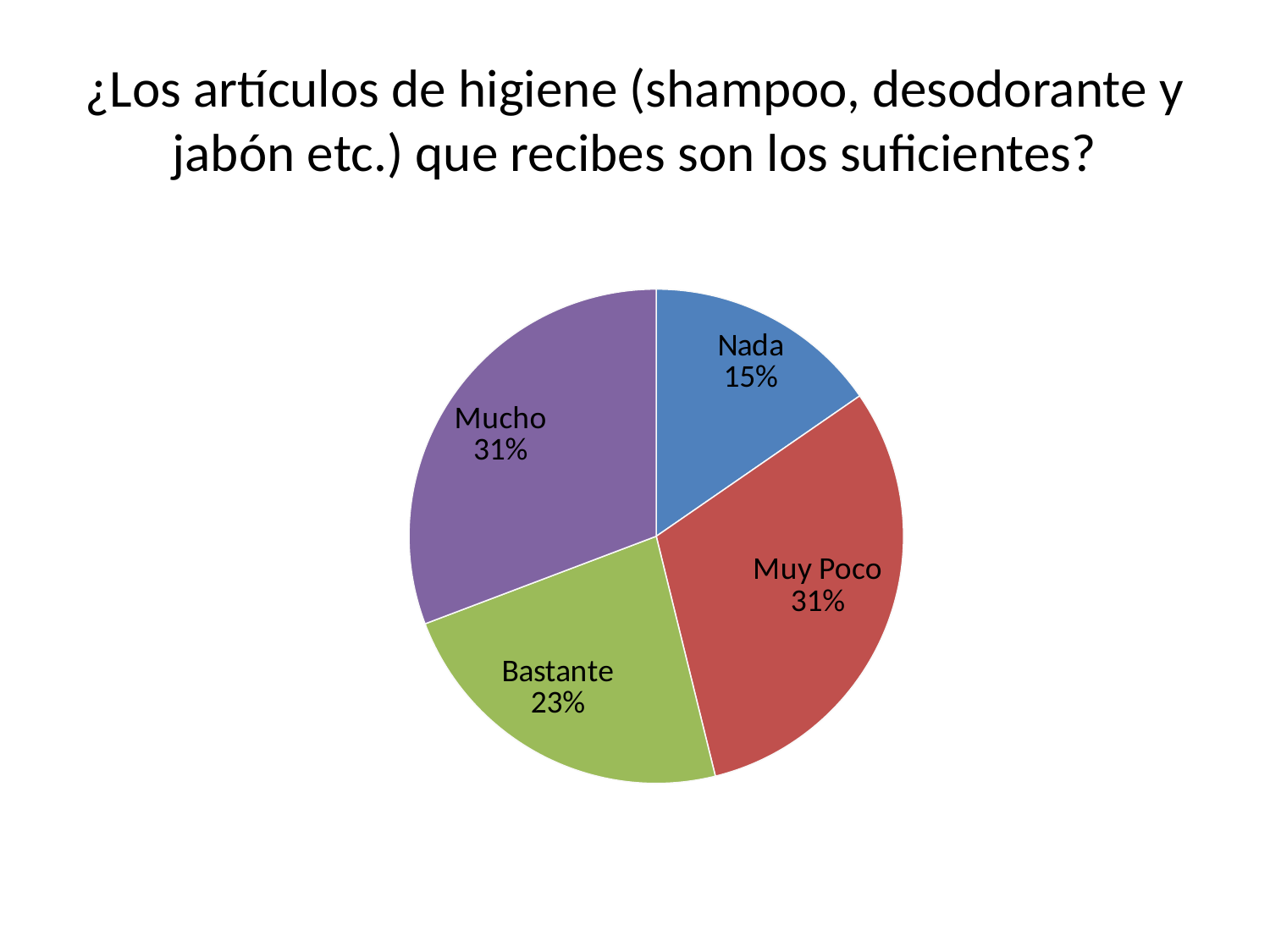
What is the difference in percentage points between the Muy Poco slice and the Nada slice? 16 Which category has the smallest slice of the pie? Nada What is the difference in percentage points between the Mucho slice and the Bastante slice? 8 How many slices does the pie chart have? 4 What kind of chart is shown on the slide? Pie chart What share of the pie does Bastante represent? 23% What share of the pie does Nada represent? 15% Which is larger, the slice for Mucho or the slice for Bastante? Mucho What colour is the Muy Poco slice? Red What share of the pie does Muy Poco represent? 31% Which is larger, the slice for Bastante or the slice for Nada? Bastante